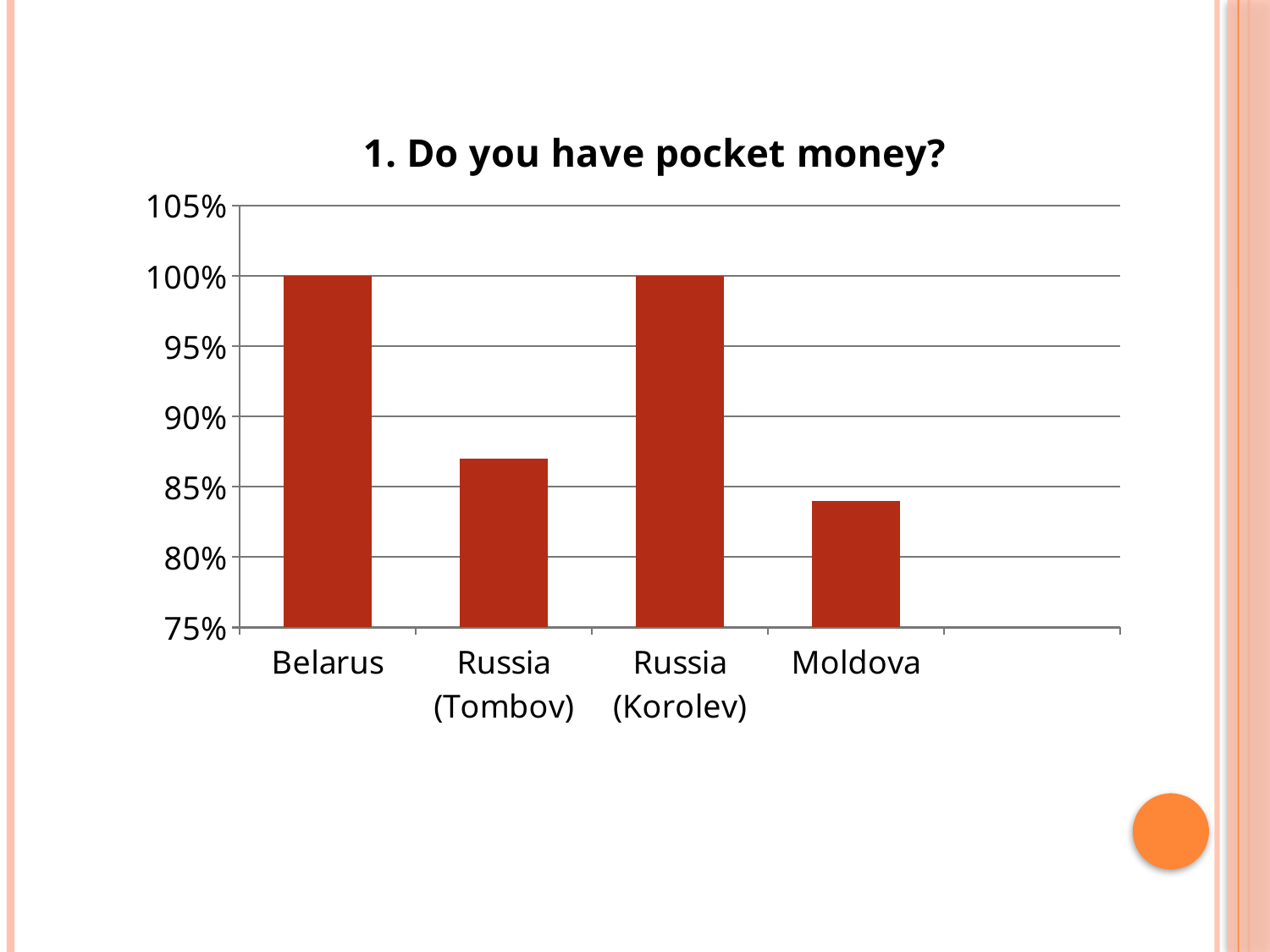
What kind of chart is shown on the slide? bar chart Which is larger, the value for Belarus or the value for Moldova? Belarus Which category has the lowest value? Moldova Is the value for Russia (Tombov) greater or less than 90%? less Which is larger, the value for Russia (Tombov) or the value for Moldova? Russia (Tombov) Is the value for Russia (Tombov) greater or less than 85%? greater What is the value for Belarus? 100% Is the value for Moldova greater or less than 85%? less What is the title of the chart? 1. Do you have pocket money? How many categories are shown on the x axis? 4 What is the value for Russia (Korolev)? 100%